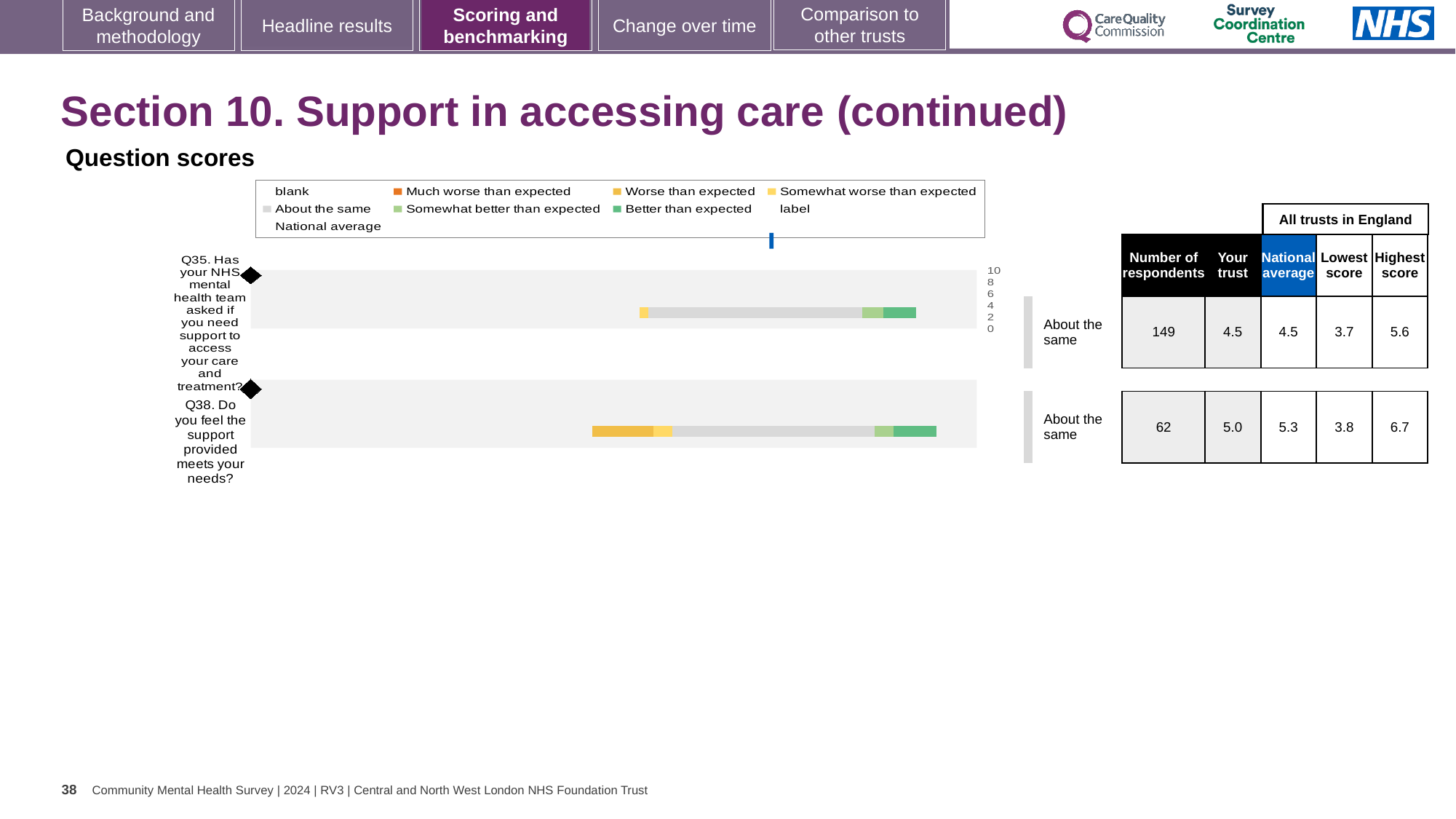
What kind of chart is used to show the question scores on this slide? bar chart What is the 'Your trust' score for Q35 (Has your NHS mental health team asked if you need support to access your care and treatment?)? 4.5 What is the 'Your trust' score for Q38 (Do you feel the support provided meets your needs?)? 5.0 What is the highest score among all trusts in England for Q38? 6.7 How many respondents answered Q35? 149 How is the trust's result for Q38 categorised relative to expectations? About the same Which question has more respondents, Q35 or Q38? Q35 For Q38, which is larger: the trust's score or the national average? National average What is the national average score for Q38? 5.3 How many questions are plotted in the question scores chart? 2 What is the difference between the highest and lowest scores for Q38 across all trusts in England? 2.9 What is the lowest score among all trusts in England for Q35? 3.7